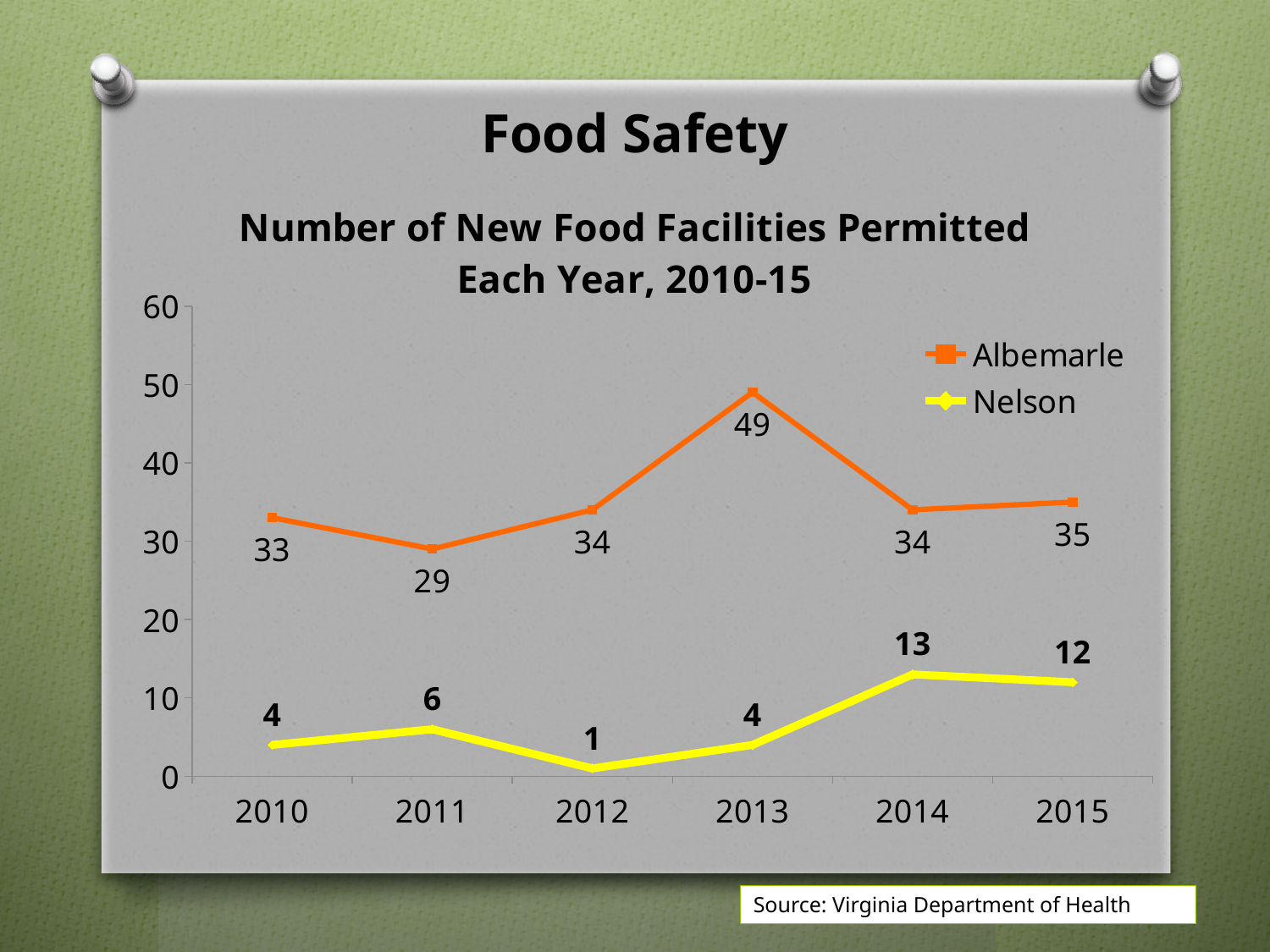
What was the number of new food facilities permitted in Nelson in 2012? 1 How many years are shown on the x axis? 6 Which had more new food facilities permitted in 2015, Albemarle or Nelson? Albemarle In which year did Nelson have the lowest number of new food facilities permitted? 2012 What kind of chart is shown on the slide? line chart What is the difference between the Albemarle and Nelson values in 2014? 21 How many series does the legend list? 2 What was the value for Albemarle in 2011? 29 What is the source cited for the chart? Virginia Department of Health In which year did Albemarle have the highest number of new food facilities permitted? 2013 Is the value for Albemarle in 2013 greater or less than 40? greater What was the number of new food facilities permitted in Albemarle in 2013? 49